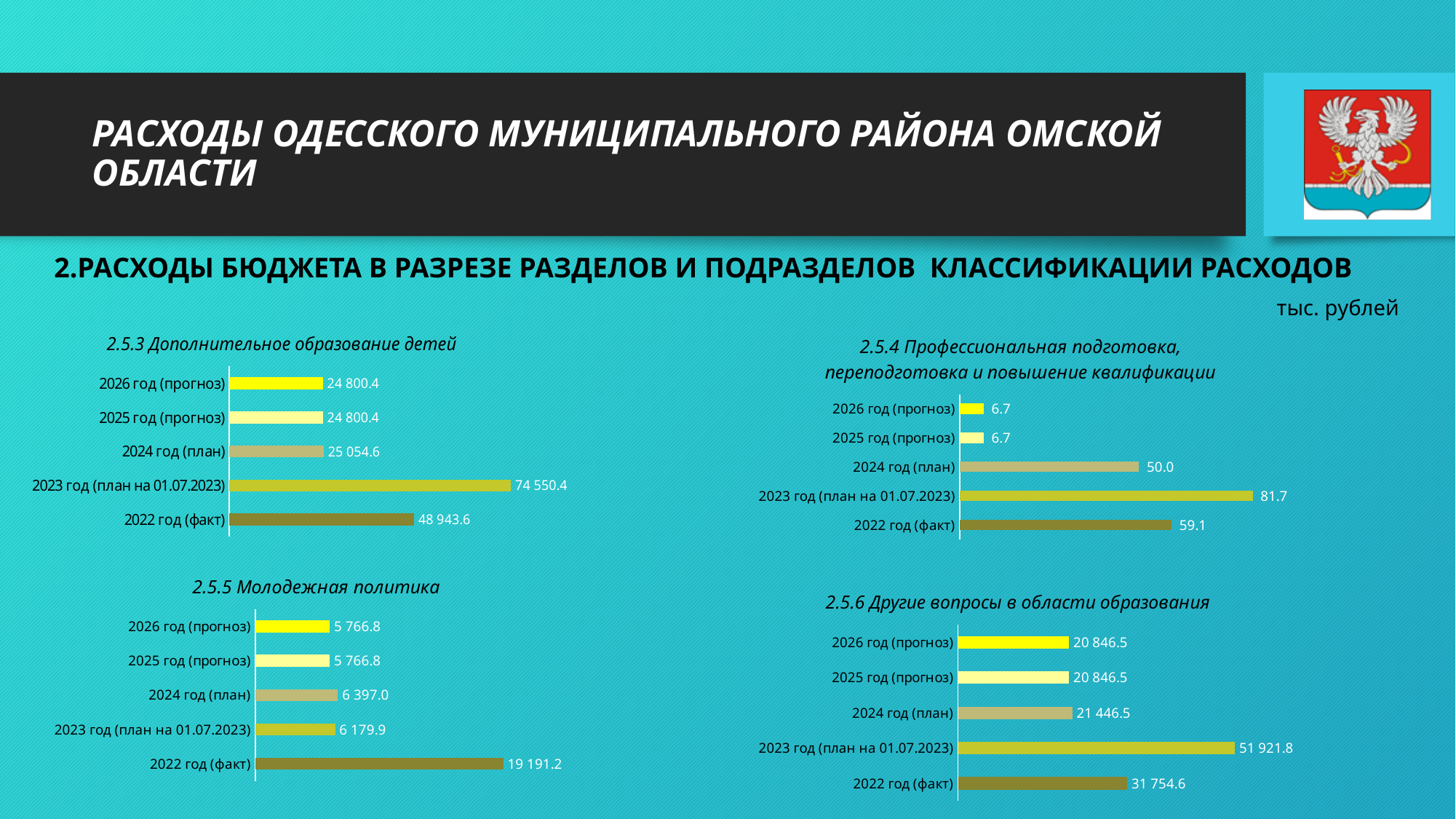
In the chart '2.5.4 Профессиональная подготовка, переподготовка и повышение квалификации', which category has the lowest value? 2025 год (прогноз) and 2026 год (прогноз) In the chart '2.5.3 Дополнительное образование детей', what is the difference between the values for 2023 год (план на 01.07.2023) and 2022 год (факт)? 25 606.8 In the chart '2.5.6 Другие вопросы в области образования', what is the value for 2025 год (прогноз)? 20 846.5 In the chart '2.5.3 Дополнительное образование детей', what is the value for 2023 год (план на 01.07.2023)? 74 550.4 What type of chart is '2.5.6 Другие вопросы в области образования'? Bar chart In the chart '2.5.5 Молодежная политика', how many categories are plotted? 5 In the chart '2.5.5 Молодежная политика', what is the value for 2024 год (план)? 6 397.0 In the chart '2.5.6 Другие вопросы в области образования', what is the difference between the values for 2023 год (план на 01.07.2023) and 2022 год (факт)? 20 167.2 In the chart '2.5.4 Профессиональная подготовка, переподготовка и повышение квалификации', what is the value for 2022 год (факт)? 59.1 In the chart '2.5.4 Профессиональная подготовка, переподготовка и повышение квалификации', what is the difference between the values for 2023 год (план на 01.07.2023) and 2022 год (факт)? 22.6 In the chart '2.5.5 Молодежная политика', which is larger: the value for 2024 год (план) or 2023 год (план на 01.07.2023)? 2024 год (план) In the chart '2.5.3 Дополнительное образование детей', which category has the highest value? 2023 год (план на 01.07.2023)